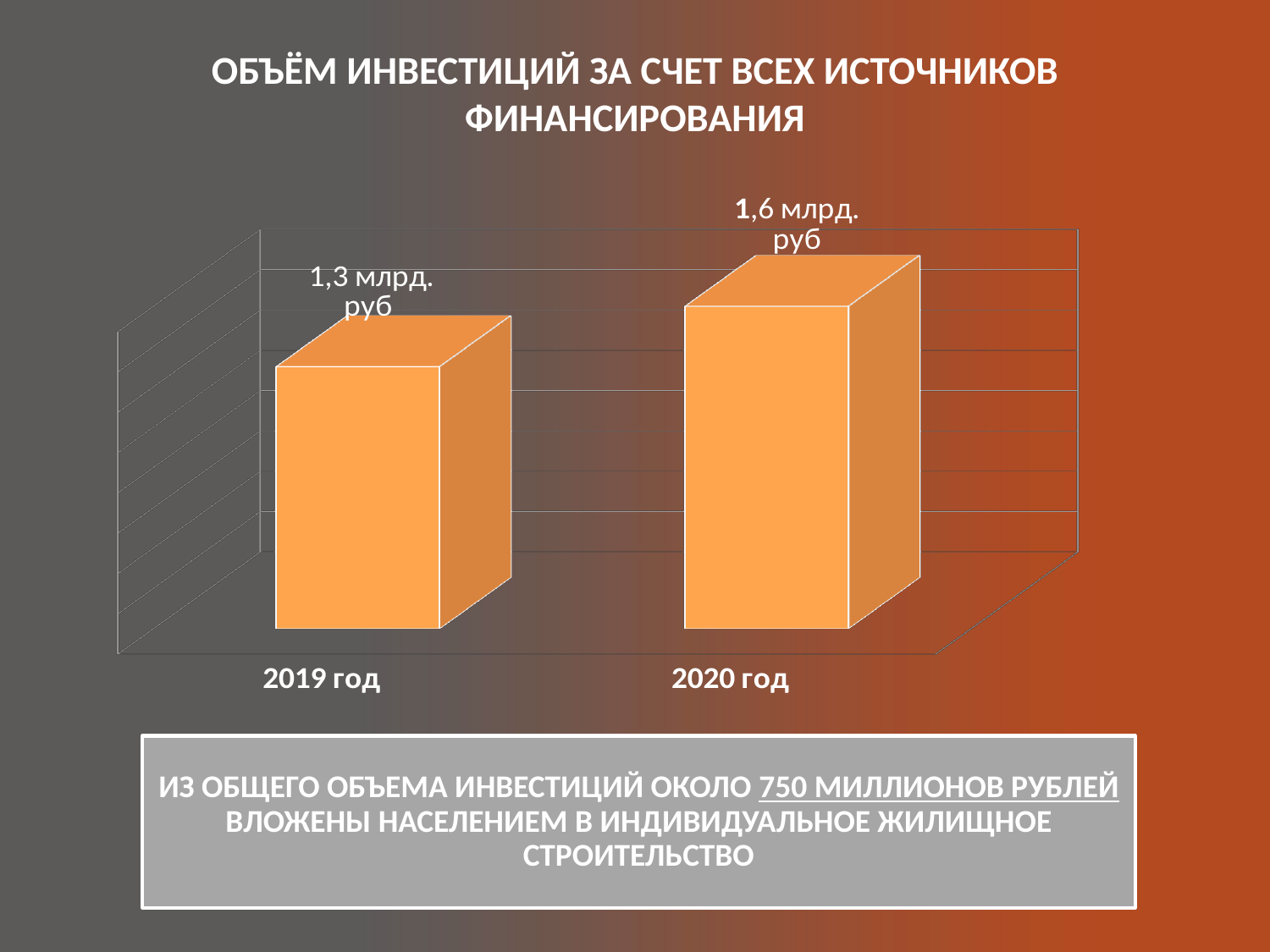
What is the value for 2020 год? 1,6 млрд. руб Which year has the lowest investment volume? 2019 год What is the title of the chart? ОБЪЁМ ИНВЕСТИЦИЙ ЗА СЧЕТ ВСЕХ ИСТОЧНИКОВ ФИНАНСИРОВАНИЯ Do the values rise or fall from 2019 год to 2020 год? rise Which is larger, the value for 2019 год or for 2020 год? 2020 год What colour are the bars on the chart? orange What is the value for 2019 год? 1,3 млрд. руб What kind of chart is shown on the slide? bar chart Which year has the highest investment volume? 2020 год How many categories are shown on the chart? 2 What is the difference between the values for 2020 год and 2019 год? 0,3 млрд. руб